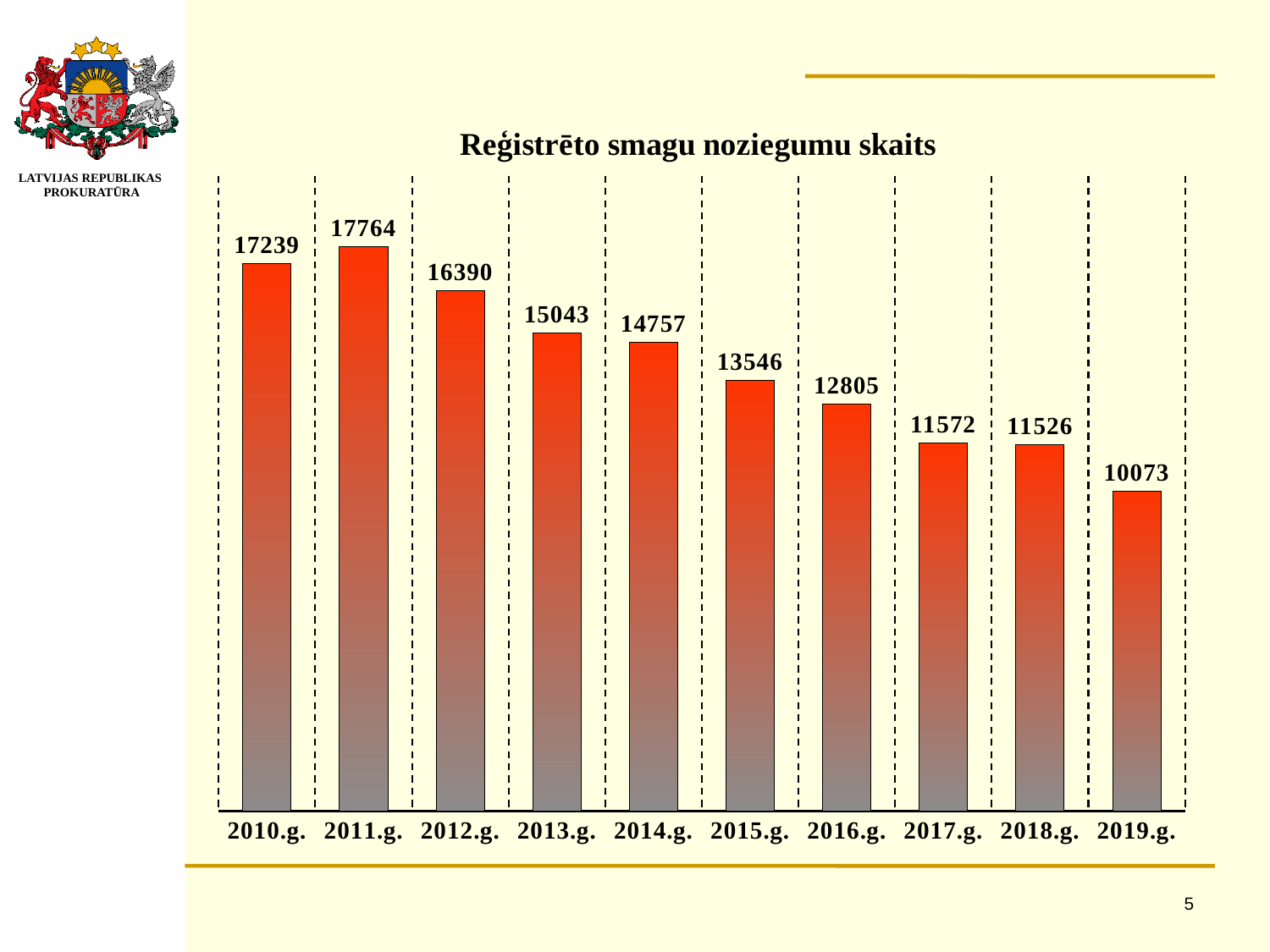
What is the value for 2015.g.? 13546 What is the difference between the values for 2010.g. and 2019.g.? 7166 What is the value for 2010.g.? 17239 Which year has the lowest value? 2019.g. Do the values generally rise or fall from 2011.g. to 2019.g.? fall What is the value for 2019.g.? 10073 What is the difference between the values for 2011.g. and 2012.g.? 1374 What kind of chart is this? bar chart Which year has the highest value? 2011.g. What is the title of the chart? Reģistrēto smagu noziegumu skaits How many years are shown on the x axis? 10 Which is larger, the value for 2013.g. or the value for 2014.g.? 2013.g.